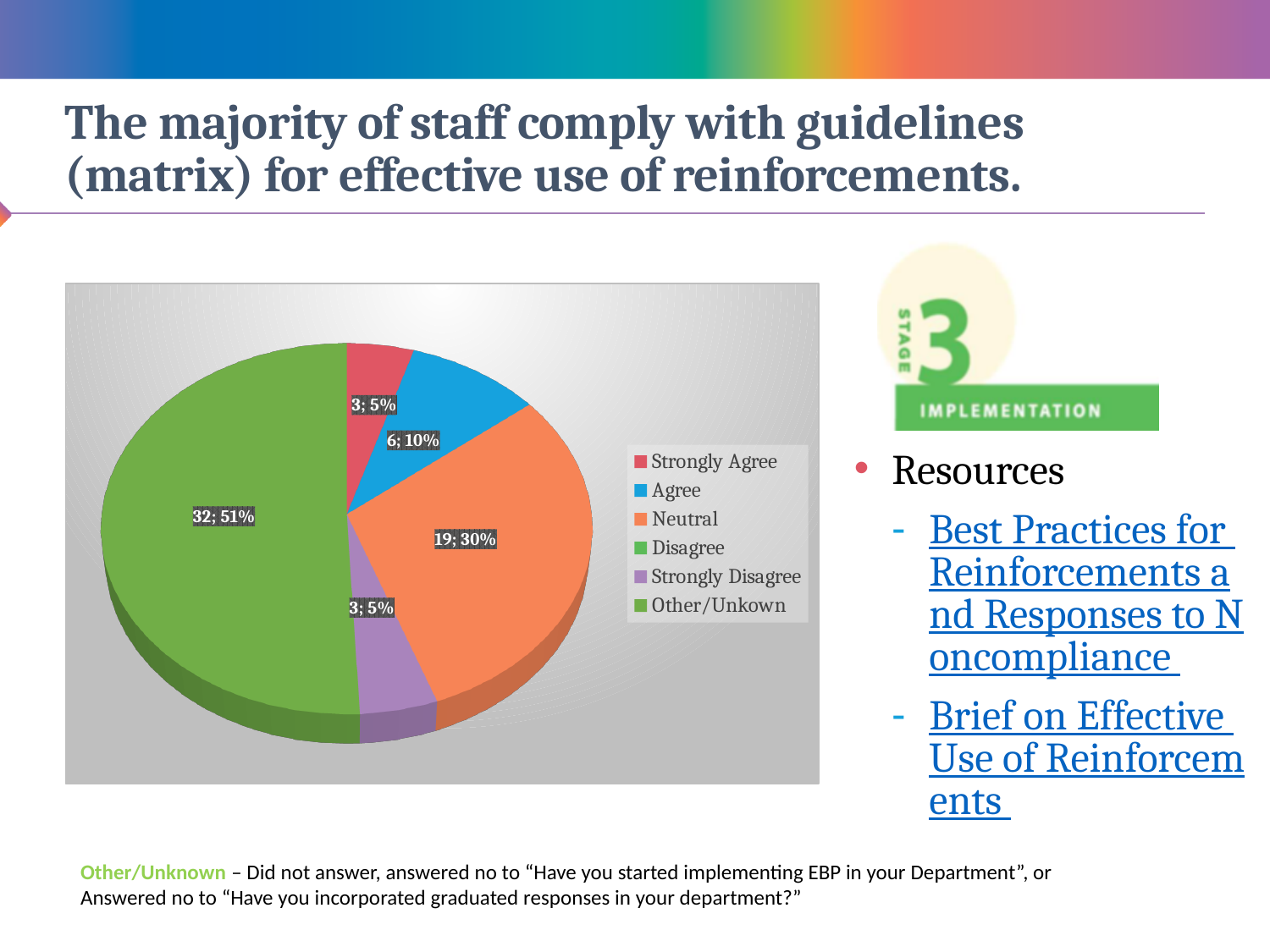
What percentage share of the pie does the Other/Unknown slice have? 51% How many respondents are in the Strongly Agree slice? 3 Which slice is larger, Agree or Neutral? Neutral What kind of chart is shown on the slide? pie chart What is the data label for the Agree slice? 6; 10% How many more respondents are in the Neutral slice than in the Agree slice? 13 What is the combined number of respondents in the Strongly Agree and Agree slices? 9 Which category has the largest slice of the pie? Other/Unknown What percentage share of the pie does the Neutral slice have? 30% How many categories does the legend list? 6 What is the data label for the Neutral slice? 19; 30% What colour is used for the Neutral slice? orange